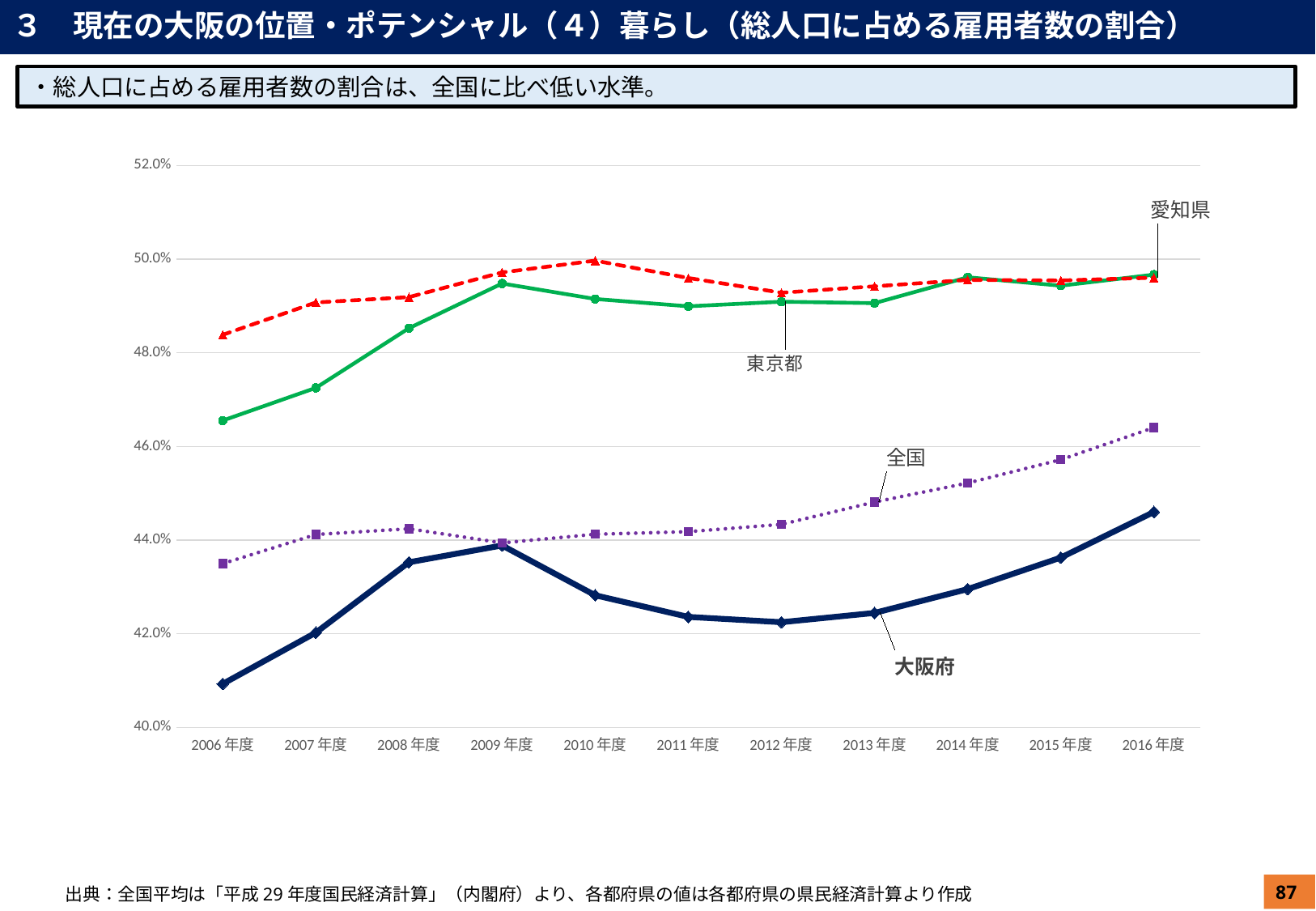
What kind of chart is shown on the slide? line chart Which series has the lowest value in 2016年度? 大阪府 Does the value for 大阪府 rise or fall from 2012年度 to 2016年度? rise How many series (lines) are plotted on the chart? 4 Is the value for 東京都 in 2006年度 greater or less than 46.0%? greater How many fiscal years are plotted along the x axis? 11 Which series is drawn as a red dashed line? 愛知県 In 2016年度, which is larger, the value for 大阪府 or the value for 全国? 全国 In 2006年度, which is larger, the value for 東京都 or the value for 愛知県? 愛知県 Is the value for 大阪府 in 2006年度 greater or less than 42.0%? less Is the value for 全国 in 2016年度 greater or less than 46.0%? greater